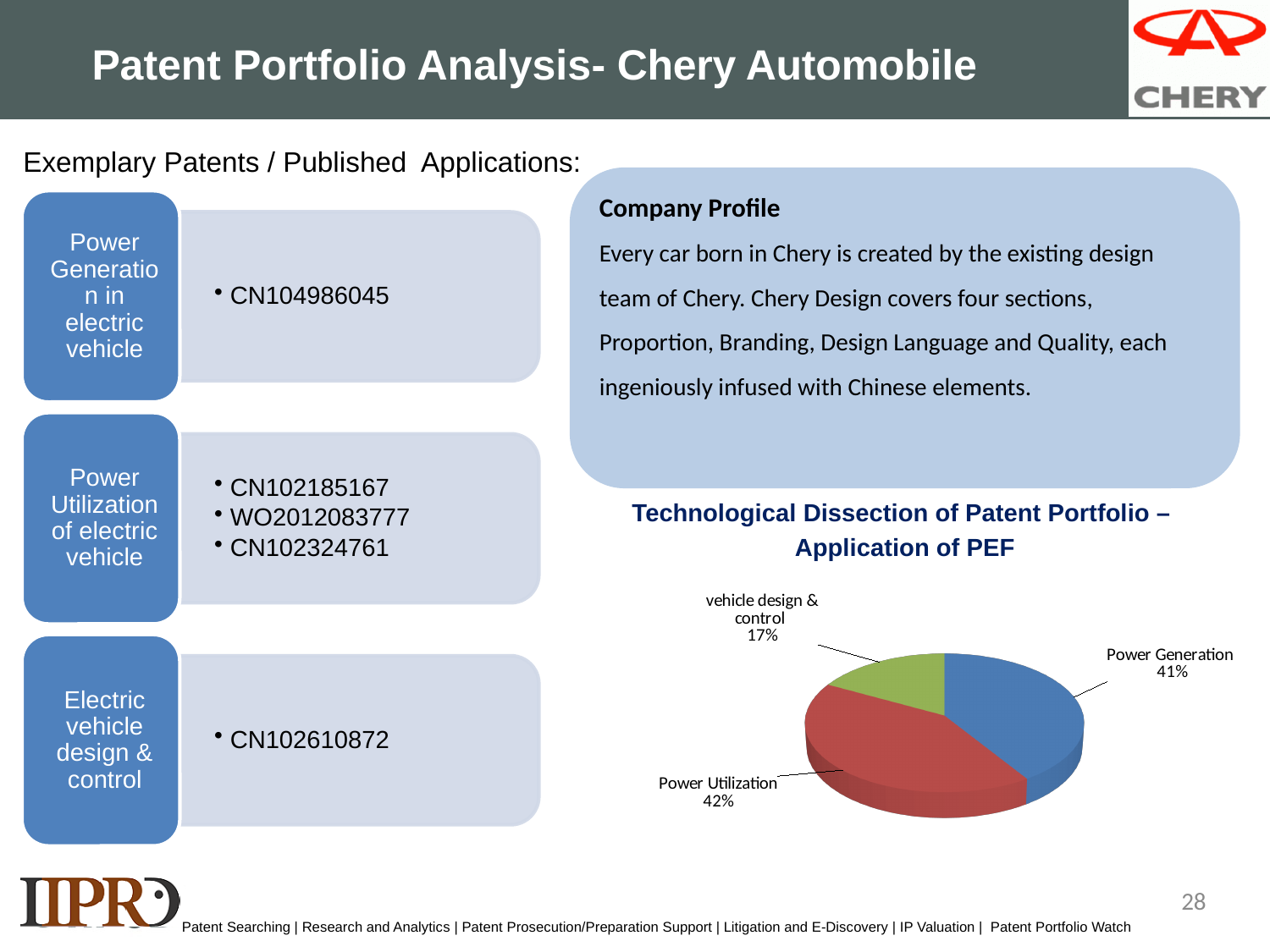
Which is larger, the slice for Power Utilization or the slice for vehicle design & control? Power Utilization What share of the pie does vehicle design & control have? 17% Which category has the smallest slice of the pie? vehicle design & control What is the difference in percentage points between the Power Generation slice and the vehicle design & control slice? 24 What colour is the Power Utilization slice in the pie chart? red What is the difference in percentage points between the Power Utilization slice and the vehicle design & control slice? 25 What kind of chart is shown on the slide? pie chart What share of the pie does Power Utilization have? 42% What share of the pie does Power Generation have? 41% What is the title of the pie chart? Technological Dissection of Patent Portfolio – Application of PEF How many slices does the pie chart have? 3 Which is larger, the slice for Power Generation or the slice for vehicle design & control? Power Generation